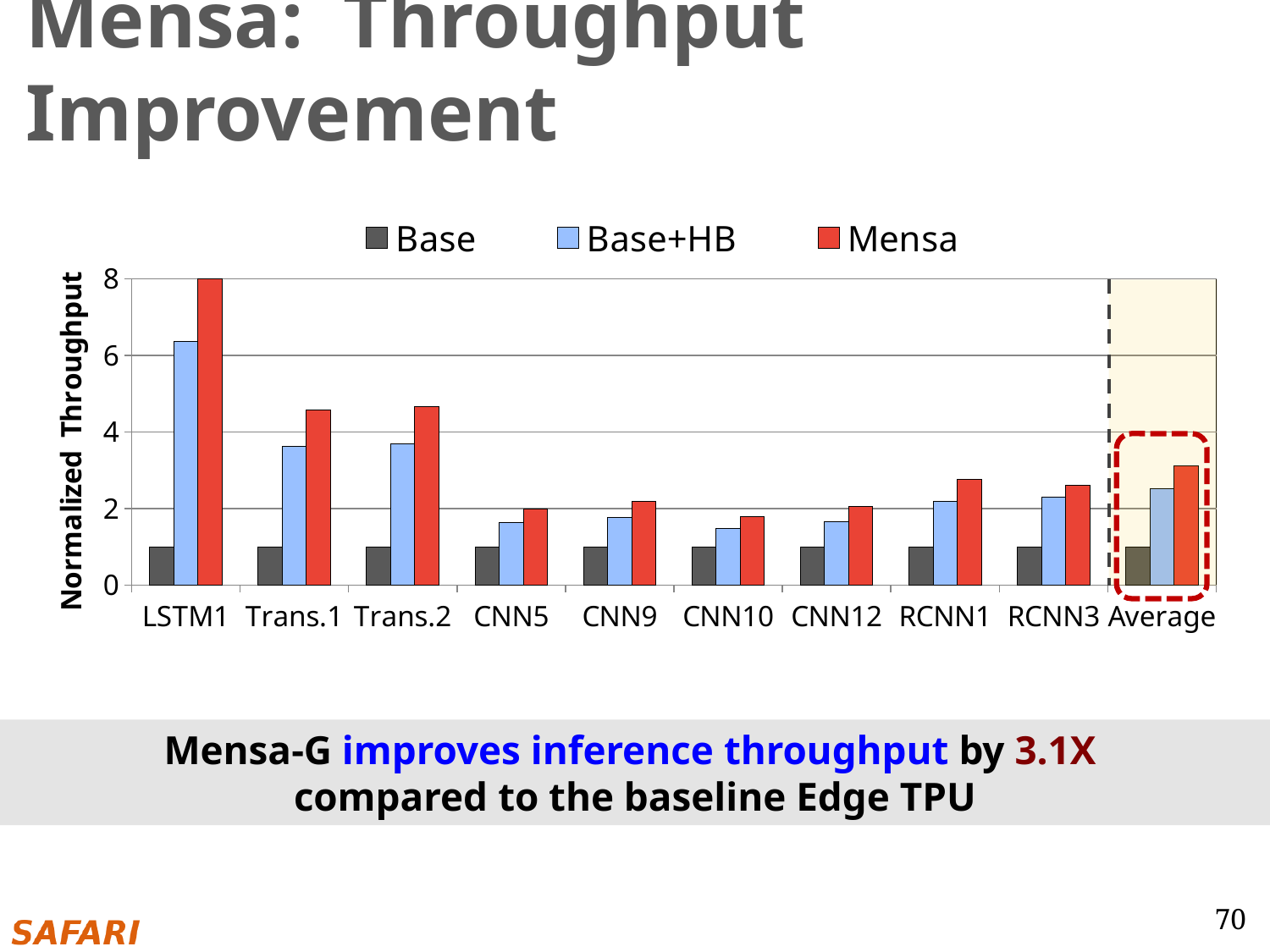
How many series does the legend list? 3 Which is larger: the Base+HB value for LSTM1 or the Mensa value for Trans.1? Base+HB value for LSTM1 Is the Base+HB value for LSTM1 greater or less than 6? greater Which category is enclosed by the red dashed box? Average How many categories are shown along the x axis? 10 Which category has the highest Mensa bar? LSTM1 Is the Mensa value for Trans.1 greater or less than 4? greater Is the Mensa value for CNN5 greater or less than 4? less What is the label of the y axis? Normalized Throughput What kind of chart is shown on the slide? bar chart Which category has the lowest Mensa bar? CNN10